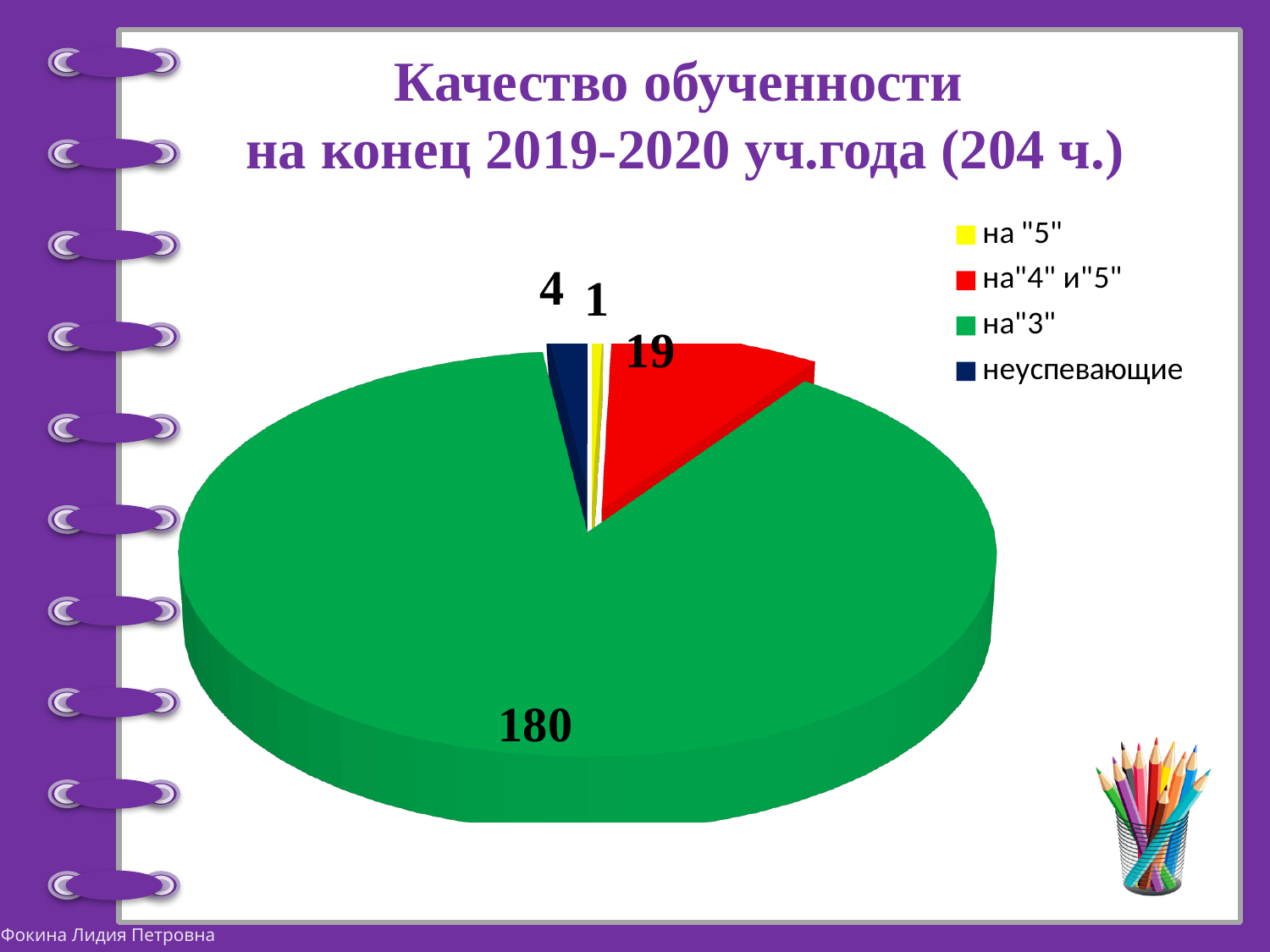
Which is larger, the value for "неуспевающие" or the value for "на "5""? неуспевающие What is the value for the "на"4" и"5"" slice? 19 What is the total of all the slices in the pie? 204 What is the difference between the values for "на"3"" and "на"4" и"5""? 161 Which category has the largest slice of the pie? на"3" How many categories does the legend list? 4 What is the value for the "на "5"" slice? 1 What kind of chart is shown on the slide? pie chart Which category has the smallest slice of the pie? на "5" What colour is the "на"4" и"5"" slice? red What is the value for the "неуспевающие" slice? 4 What is the value for the "на"3"" slice? 180